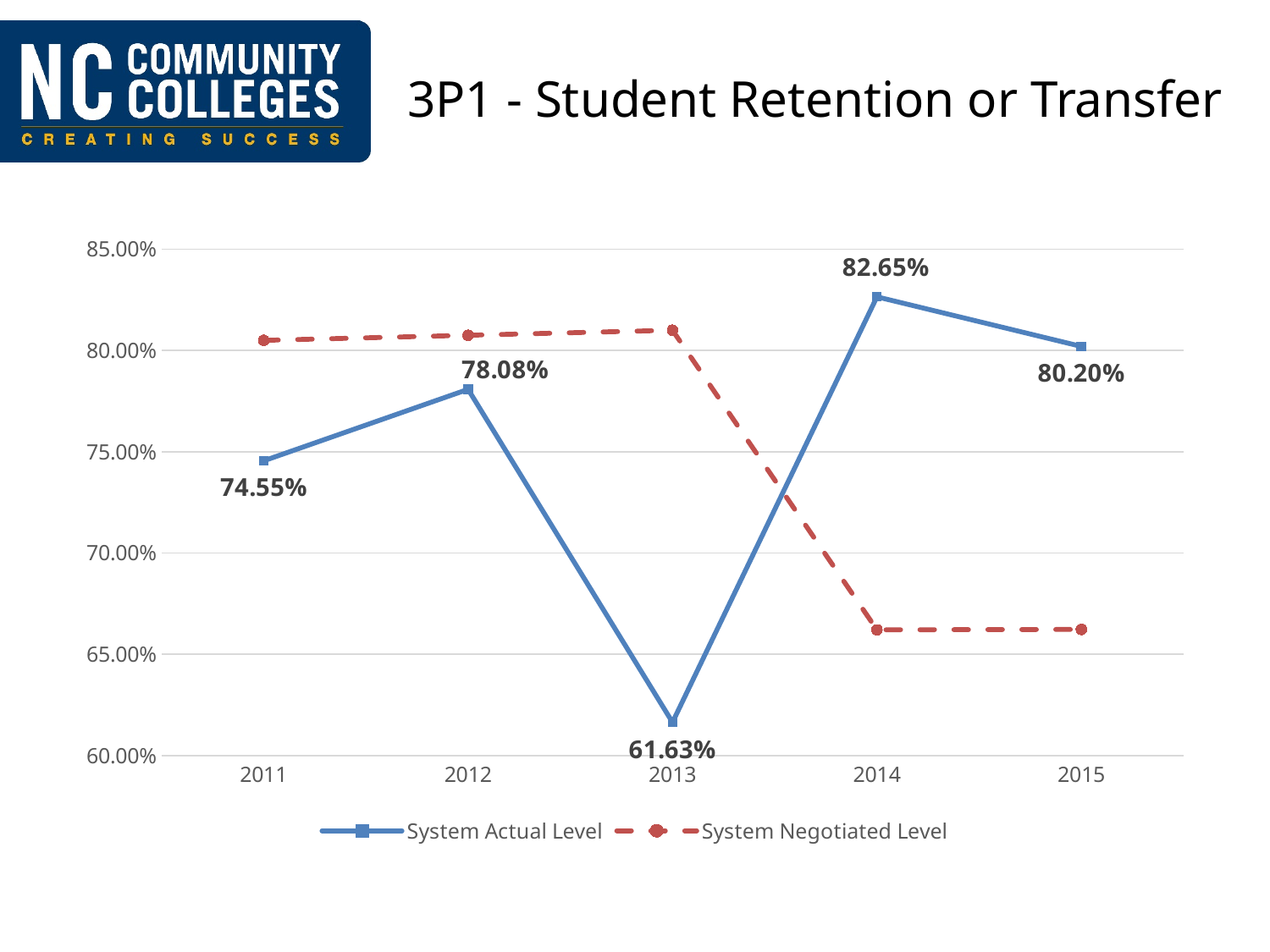
How many series does the legend list? 2 Which year has the lowest System Actual Level? 2013 Is the System Negotiated Level for 2014 greater or less than 70.00%? less What is the System Actual Level for 2014? 82.65% What is the difference between the System Actual Level in 2014 and in 2013? 21.02% What is the System Actual Level for 2011? 74.55% Which year has the highest System Actual Level? 2014 How many years are shown on the x axis? 5 What kind of chart is shown on the slide? line chart Is the System Negotiated Level for 2011 greater or less than 80.00%? greater Which is larger, the System Actual Level in 2012 or in 2015? 2015 What is the System Actual Level for 2013? 61.63%